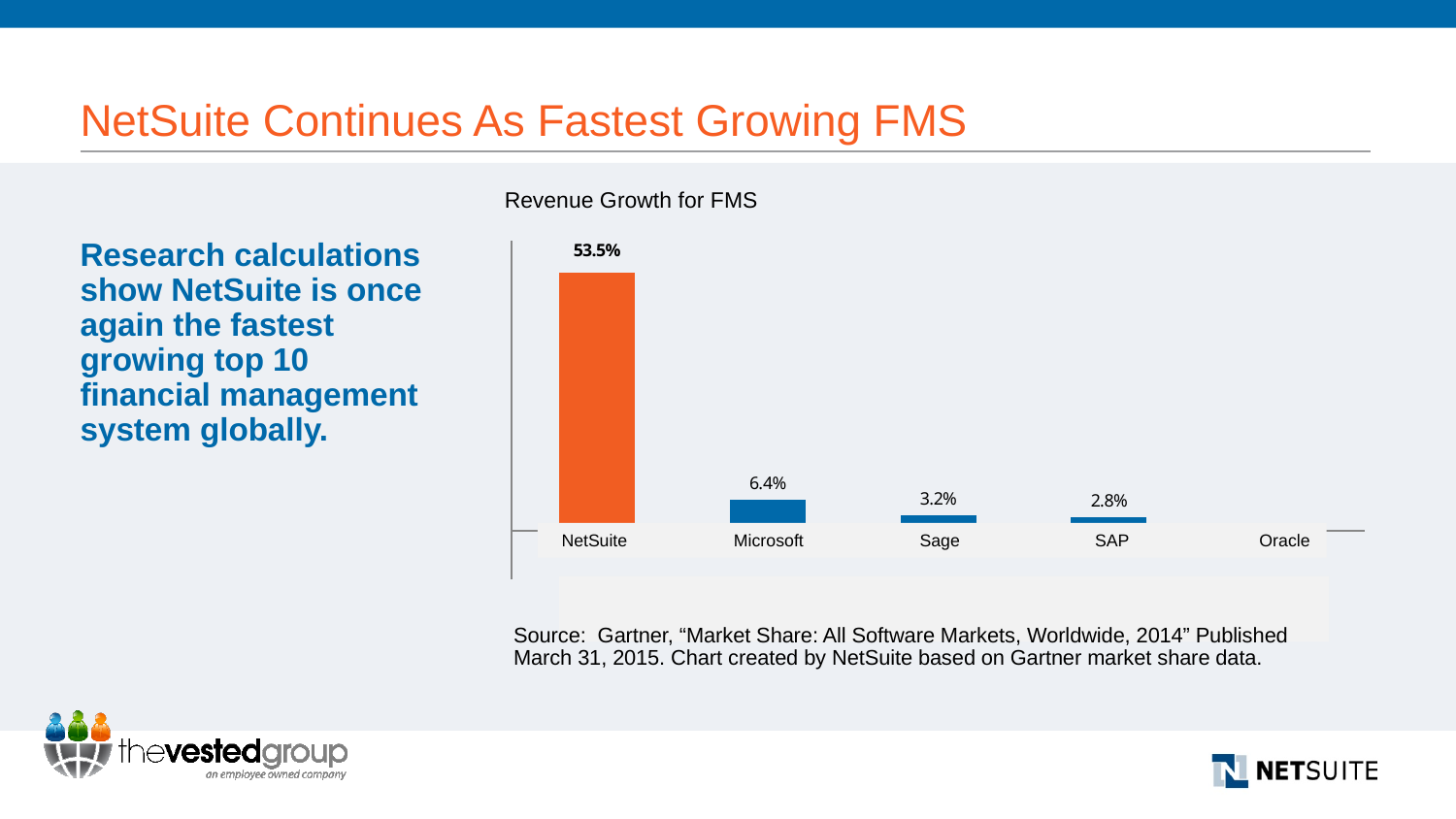
Which company has the lowest revenue growth in the chart? Oracle How many companies are shown on the x axis of the chart? 5 What is the difference between Sage's and SAP's revenue growth? 0.4% Do the revenue growth values rise or fall from left to right across the chart? Fall What is the revenue growth value shown for SAP? 2.8% Which has higher revenue growth, Microsoft or Sage? Microsoft What is the difference between NetSuite's and Microsoft's revenue growth? 47.1% Which company has the highest revenue growth in the chart? NetSuite What kind of chart is used to show revenue growth for FMS? Bar chart What is the revenue growth value shown for Sage? 3.2% What is the revenue growth value shown for NetSuite? 53.5% What is the revenue growth value shown for Microsoft? 6.4%